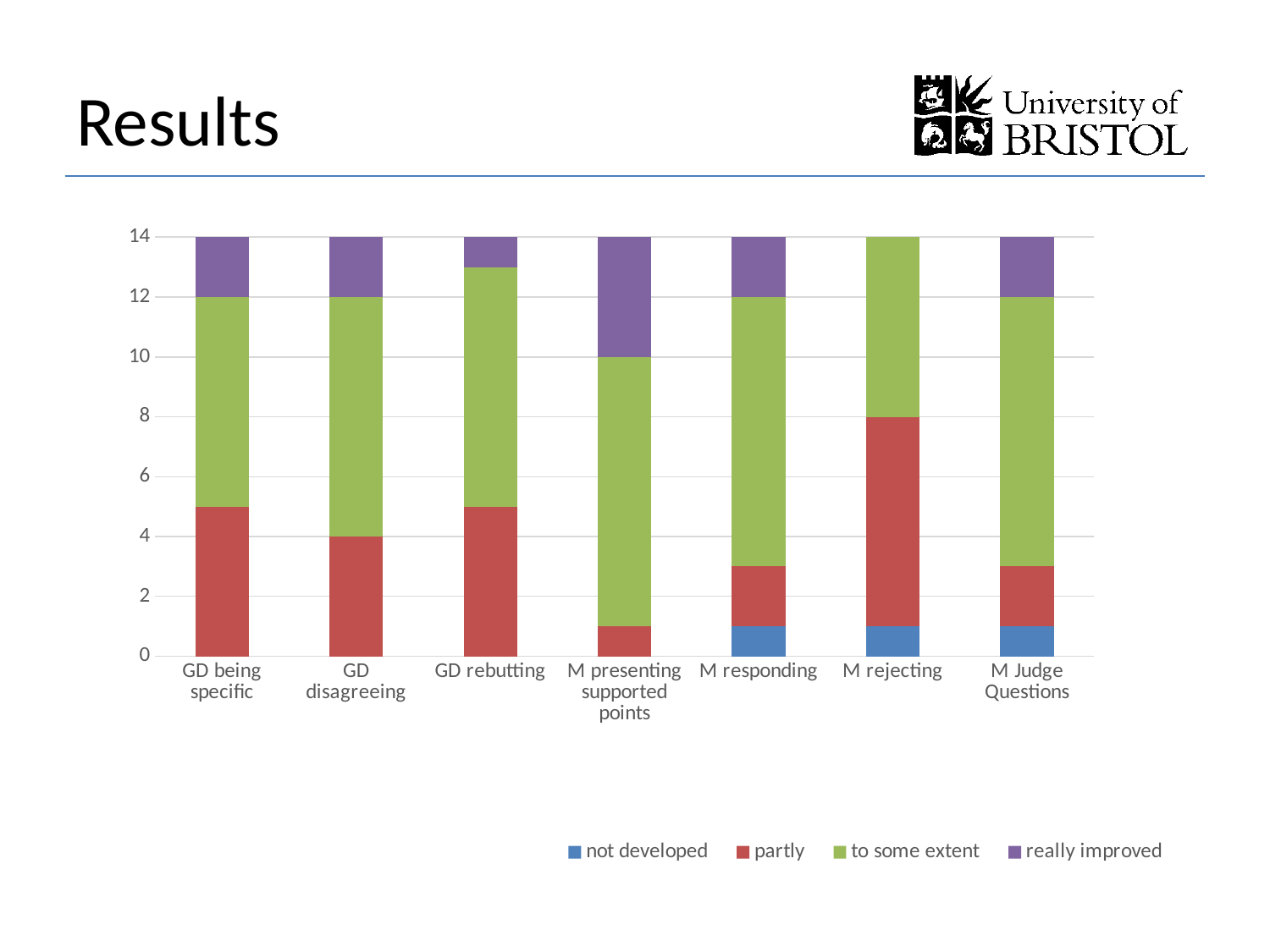
What is the value of the 'partly' segment for GD disagreeing? 4 Is the 'partly' value for M rejecting greater or less than 6? greater What kind of chart is shown on the slide? stacked bar chart Is the 'to some extent' value for M presenting supported points greater or less than 8? greater How many series does the legend list? 4 Which category has the largest 'partly' segment? M rejecting How many categories are shown along the x axis? 7 Which colour represents 'really improved' in the legend? purple